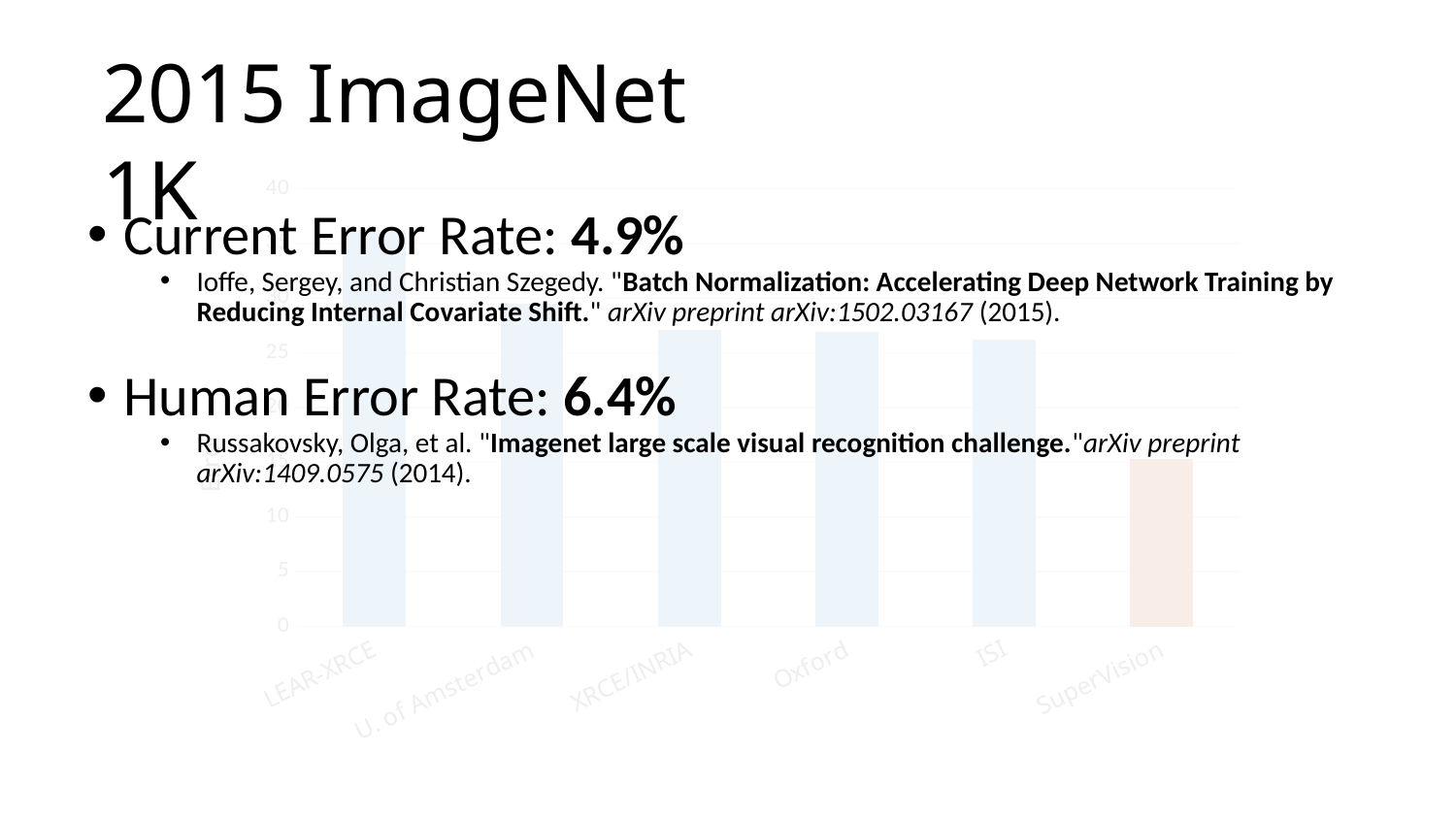
Which category has the lowest bar on the chart? SuperVision Is the value for LEAR-XRCE greater or less than 25? greater What kind of chart is shown on the slide? bar chart Is the value for U. of Amsterdam greater or less than 25? greater Which category has the highest bar on the chart? LEAR-XRCE How many categories are plotted on the bar chart? 6 Which category's bar is shown in a different colour from the others? SuperVision Do the bar values rise or fall moving from left to right along the x axis? fall Is the value for SuperVision greater or less than 10? greater Which is larger, the value for LEAR-XRCE or the value for SuperVision? LEAR-XRCE